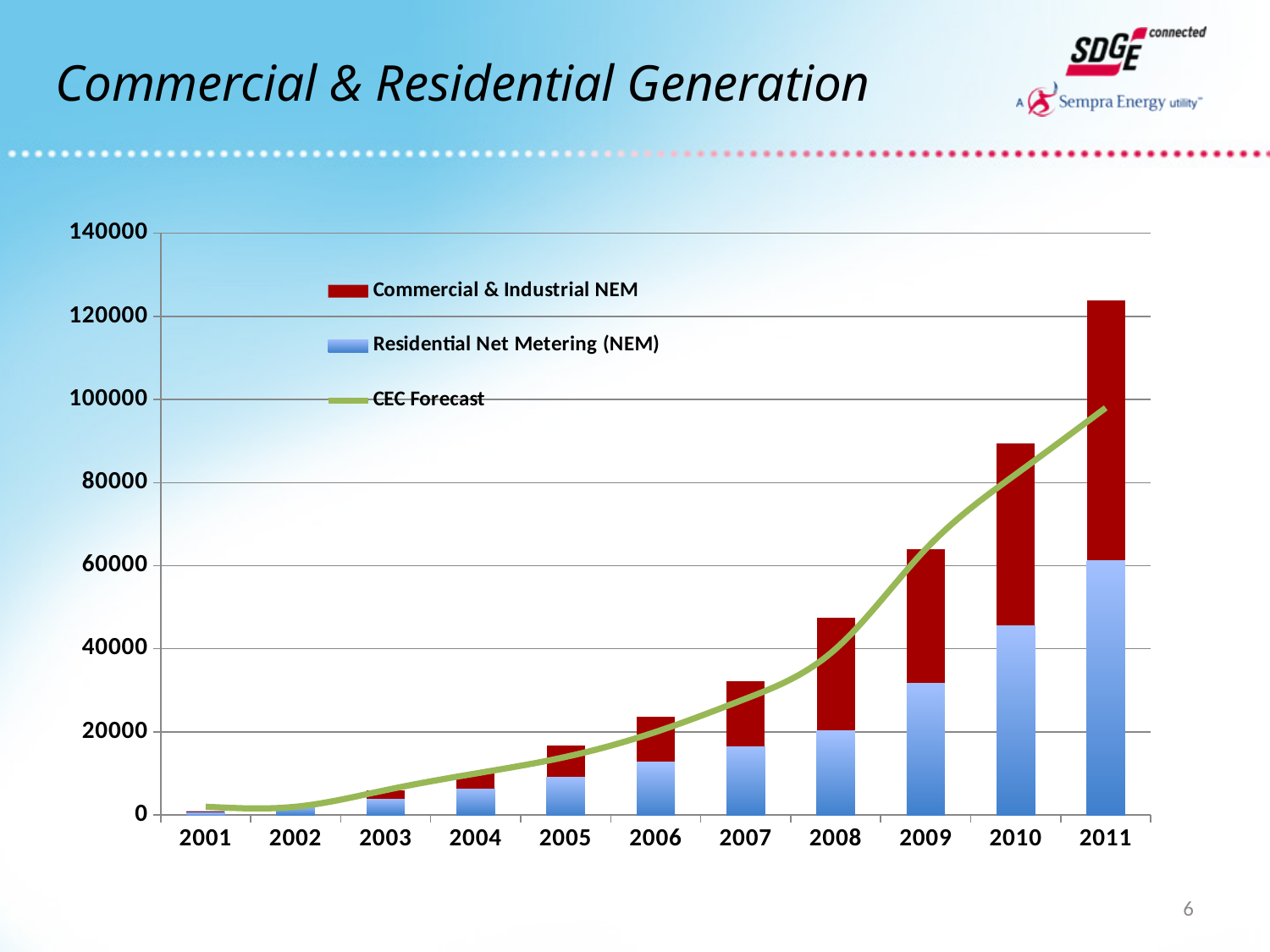
What colour is the CEC Forecast line in the legend? Green Which year has the tallest stacked bar? 2011 Is the total stacked bar value for 2010 greater or less than 100000? less Is the Residential Net Metering (NEM) value for 2010 greater or less than 40000? greater What kind of chart is shown on the slide? Stacked bar chart with a line Which year has the larger total stacked bar, 2009 or 2010? 2010 Is the total stacked bar value for 2008 greater or less than 40000? greater How many series does the legend list? 3 Do the stacked bar totals rise or fall from 2001 to 2011? Rise How many years are shown along the x axis? 11 Which year has the smallest stacked bar? 2001